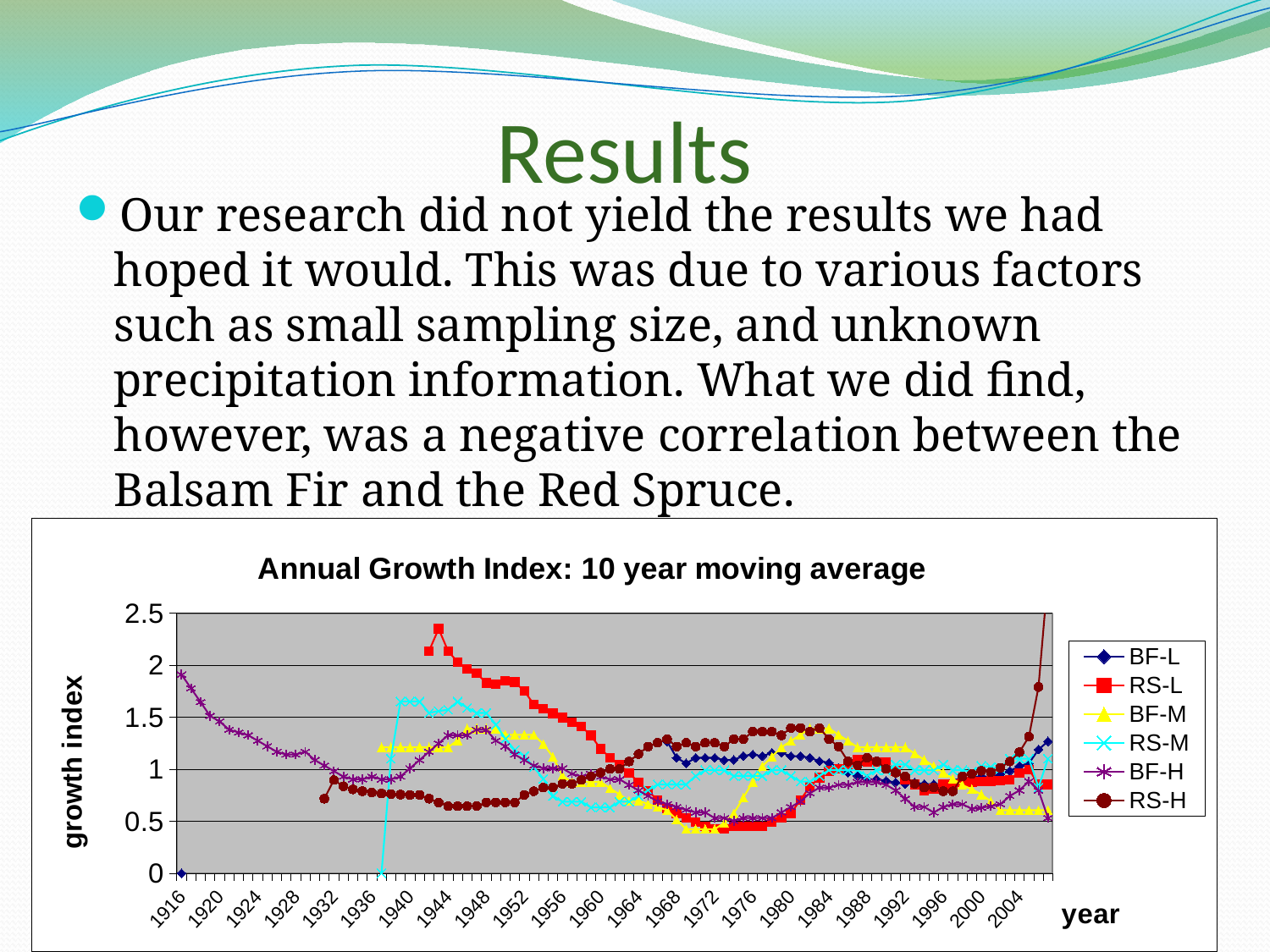
What is the label of the vertical axis of the chart? growth index Does the BF-H series rise or fall between 1916 and 1932? fall Is the value for RS-L in 1944 greater or less than 2? greater Is the value for RS-H in 1932 greater or less than 1? less How many series does the legend of the chart list? 6 Does the RS-L series rise or fall between 1944 and 1972? fall What kind of chart is shown on the slide? line chart Is the value for BF-H in 1916 greater or less than 1.5? greater What is the title of the chart? Annual Growth Index: 10 year moving average Which series reaches the highest growth index value on the chart? RS-H